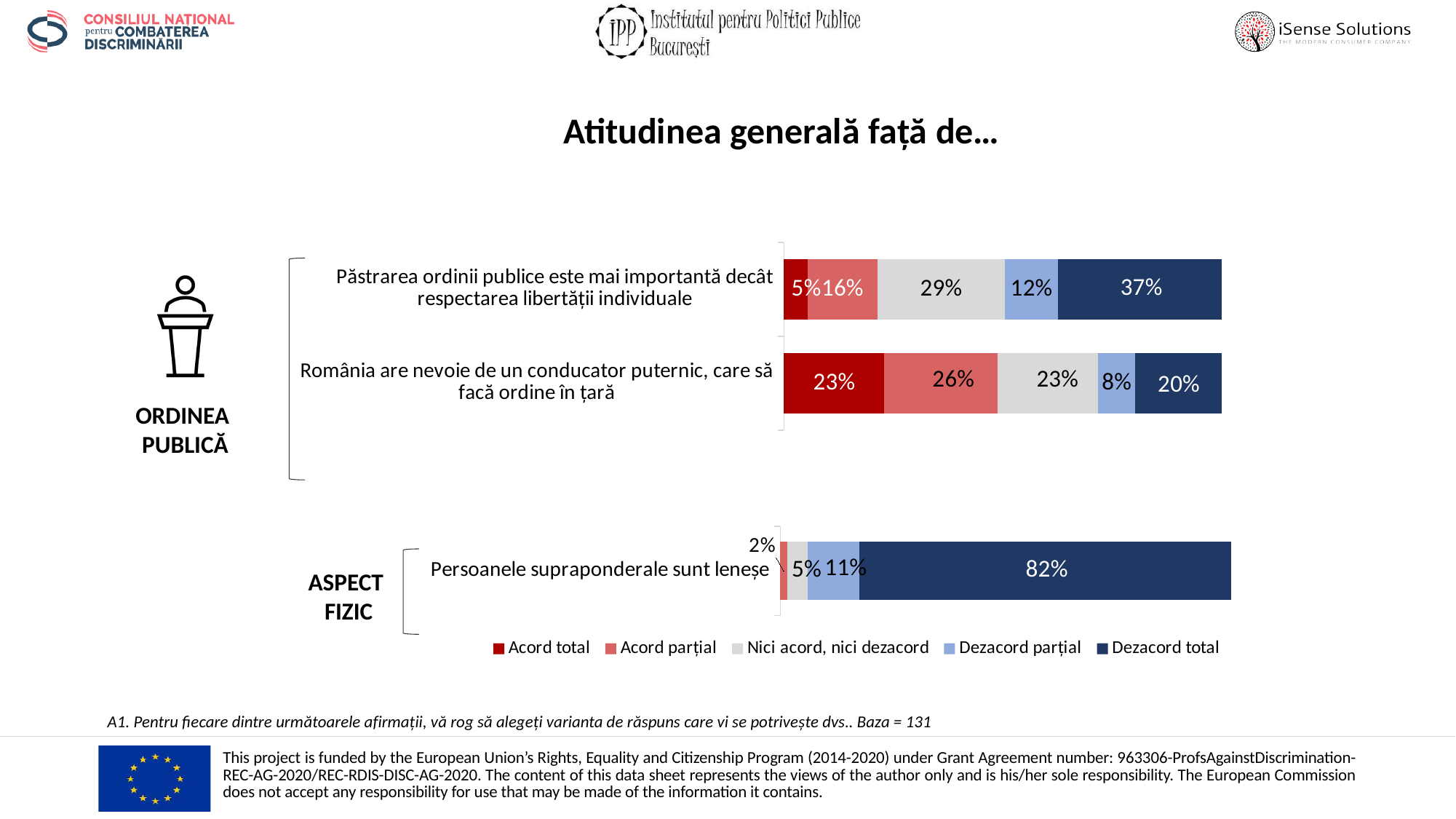
How many statements are shown in the ORDINEA PUBLICĂ chart? 2 In the ORDINEA PUBLICĂ chart, which response category has the largest share for the statement 'Păstrarea ordinii publice este mai importantă decât respectarea libertății individuale'? Dezacord total In the ORDINEA PUBLICĂ chart, what percentage chose 'Acord total' for the statement 'România are nevoie de un conducator puternic, care să facă ordine în țară'? 23% In the ORDINEA PUBLICĂ chart, which statement has the larger 'Nici acord, nici dezacord' share: 'Păstrarea ordinii publice...' or 'România are nevoie de un conducator puternic...'? Păstrarea ordinii publice este mai importantă decât respectarea libertății individuale How many response categories does the legend list? 5 In the ORDINEA PUBLICĂ chart, which response category has the smallest share for the statement 'România are nevoie de un conducator puternic, care să facă ordine în țară'? Dezacord parțial In the ORDINEA PUBLICĂ chart, how many percentage points higher is 'Dezacord total' than 'Acord total' for the statement 'Păstrarea ordinii publice este mai importantă decât respectarea libertății individuale'? 32 percentage points In the ASPECT FIZIC chart, what percentage chose 'Dezacord parțial' for the statement 'Persoanele supraponderale sunt leneșe'? 11% In the ASPECT FIZIC chart, what percentage chose 'Dezacord total' for the statement 'Persoanele supraponderale sunt leneșe'? 82% In the ORDINEA PUBLICĂ chart, which response category has the largest share for the statement 'România are nevoie de un conducator puternic, care să facă ordine în țară'? Acord parțial In the ORDINEA PUBLICĂ chart, what percentage chose 'Dezacord total' for the statement 'Păstrarea ordinii publice este mai importantă decât respectarea libertății individuale'? 37% What kind of chart is used on this slide? Stacked bar chart